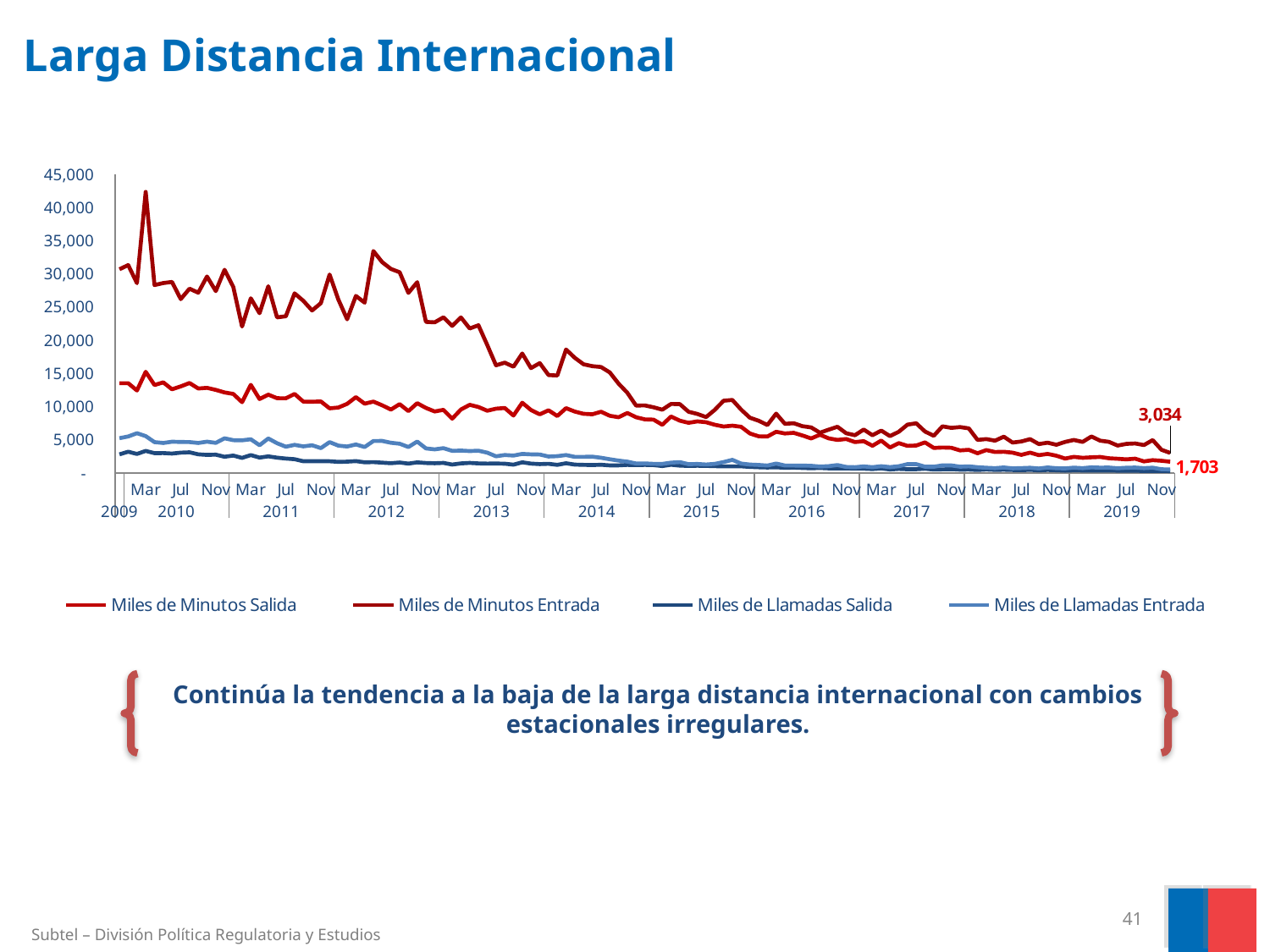
What is the title of the slide containing the chart? Larga Distancia Internacional In 2009, which series is larger: Miles de Minutos Entrada or Miles de Minutos Salida? Miles de Minutos Entrada Is the peak value of Miles de Minutos Entrada in 2009 greater or less than 40,000? less Which series are listed in the chart legend? Miles de Minutos Salida, Miles de Minutos Entrada, Miles de Llamadas Salida, Miles de Llamadas Entrada What type of chart is shown on the slide? line chart What is the overall trend of the Miles de Minutos Salida series across the x axis? falling Which series reaches the highest value on the chart? Miles de Minutos Entrada What is the highest value shown on the y axis? 45,000 Which two data labels are printed at the right end of the chart? 3,034 and 1,703 Is the value of Miles de Llamadas Entrada in 2009 greater or less than 10,000? less What is the overall trend of the Miles de Minutos Entrada series from 2009 to 2019? falling How many series does the legend list? 4